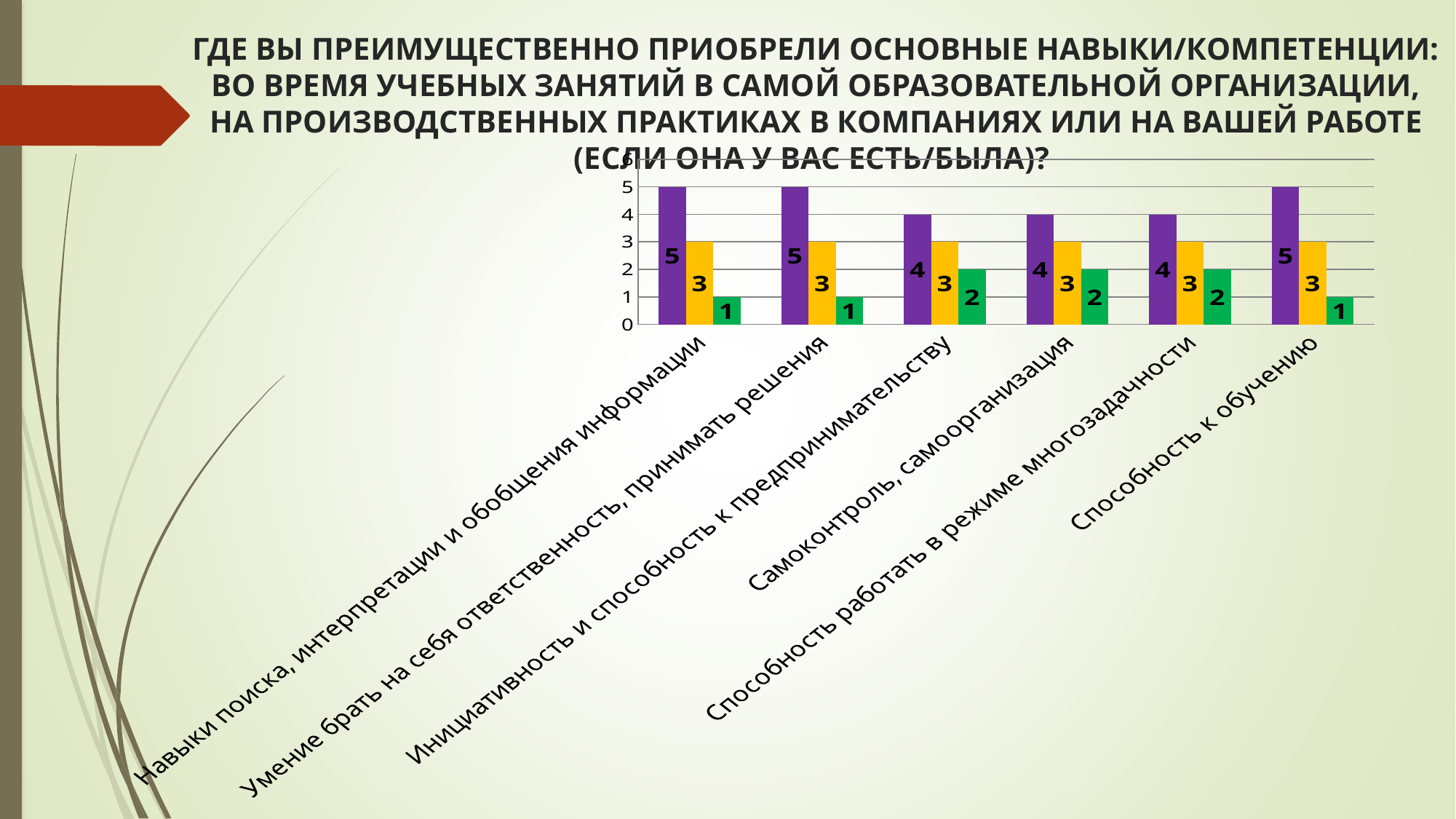
How many bars are plotted for each category in the chart? 3 What is the value of the purple bar for "Способность к обучению"? 5 Which category has the lowest purple bar value among "Способность к обучению" and "Самоконтроль, самоорганизация"? Самоконтроль, самоорганизация How many categories are shown on the x axis of the chart? 6 What kind of chart is shown on the slide? bar chart What is the total of the three bars for "Способность работать в режиме многозадачности"? 9 What is the value of the green bar for "Самоконтроль, самоорганизация"? 2 Which is larger for "Самоконтроль, самоорганизация": the purple bar or the green bar? the purple bar What is the difference between the purple bar and the green bar for "Навыки поиска, интерпретации и обобщения информации"? 4 What is the value of the yellow bar for "Инициативность и способность к предпринимательству"? 3 What is the value of the purple bar for "Способность работать в режиме многозадачности"? 4 What is the value of the green bar for "Умение брать на себя ответственность, принимать решения"? 1